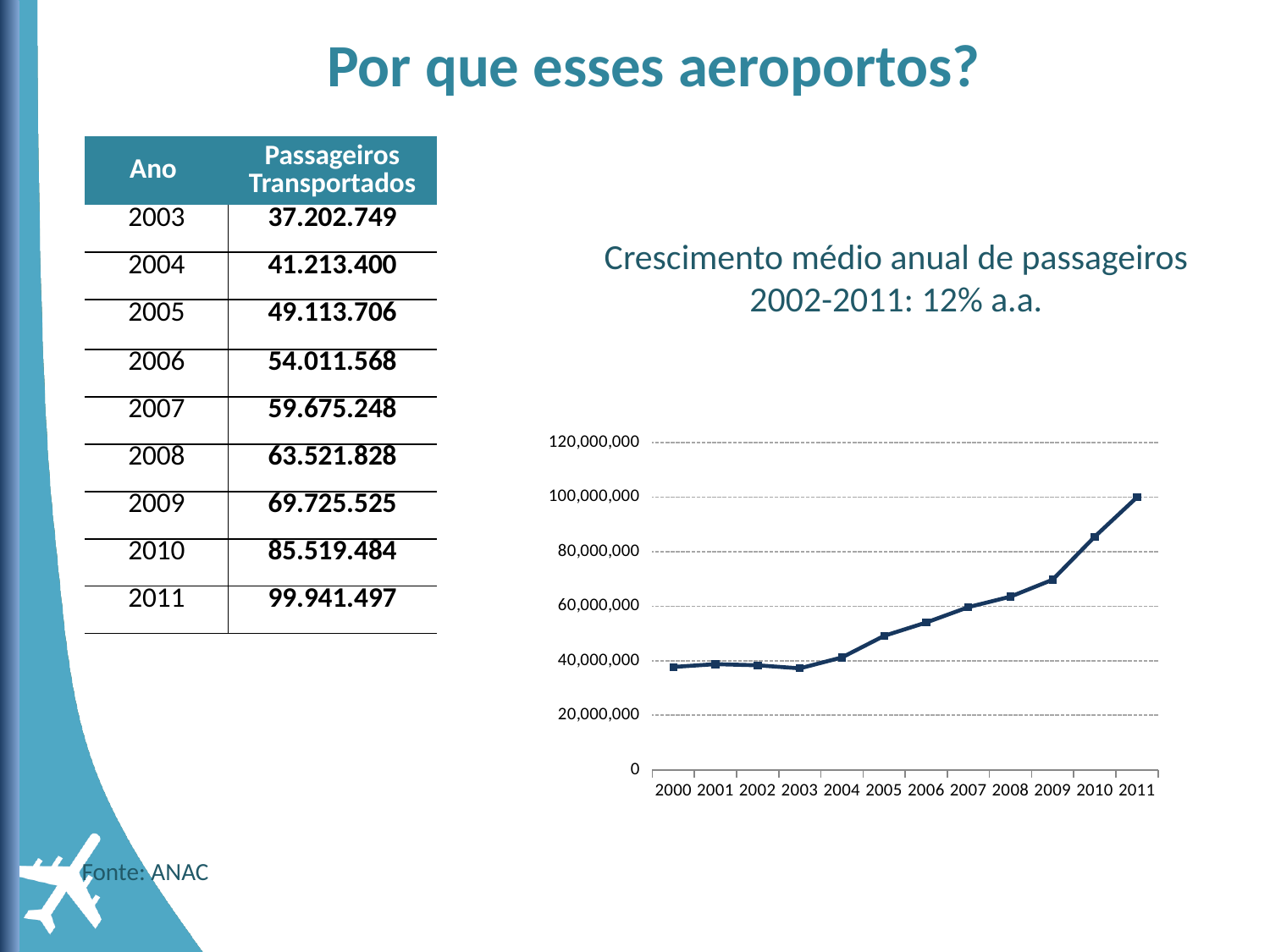
What average annual passenger growth rate for 2002-2011 does the slide state above the chart? 12% a.a. Is the value for 2000 on the chart greater or less than 40,000,000? less What kind of chart is shown on the slide? line chart Is the value for 2009 on the chart greater or less than 60,000,000? greater Do the values on the chart generally rise or fall from 2003 to 2011? rise Is the value for 2005 on the chart greater or less than 60,000,000? less Which year has the larger value on the chart, 2000 or 2011? 2011 What is the first year shown on the chart's x axis? 2000 How many years are plotted along the x axis of the chart? 12 Which year has the highest value on the chart? 2011 According to the slide, how many passengers were transported in 2011? 99.941.497